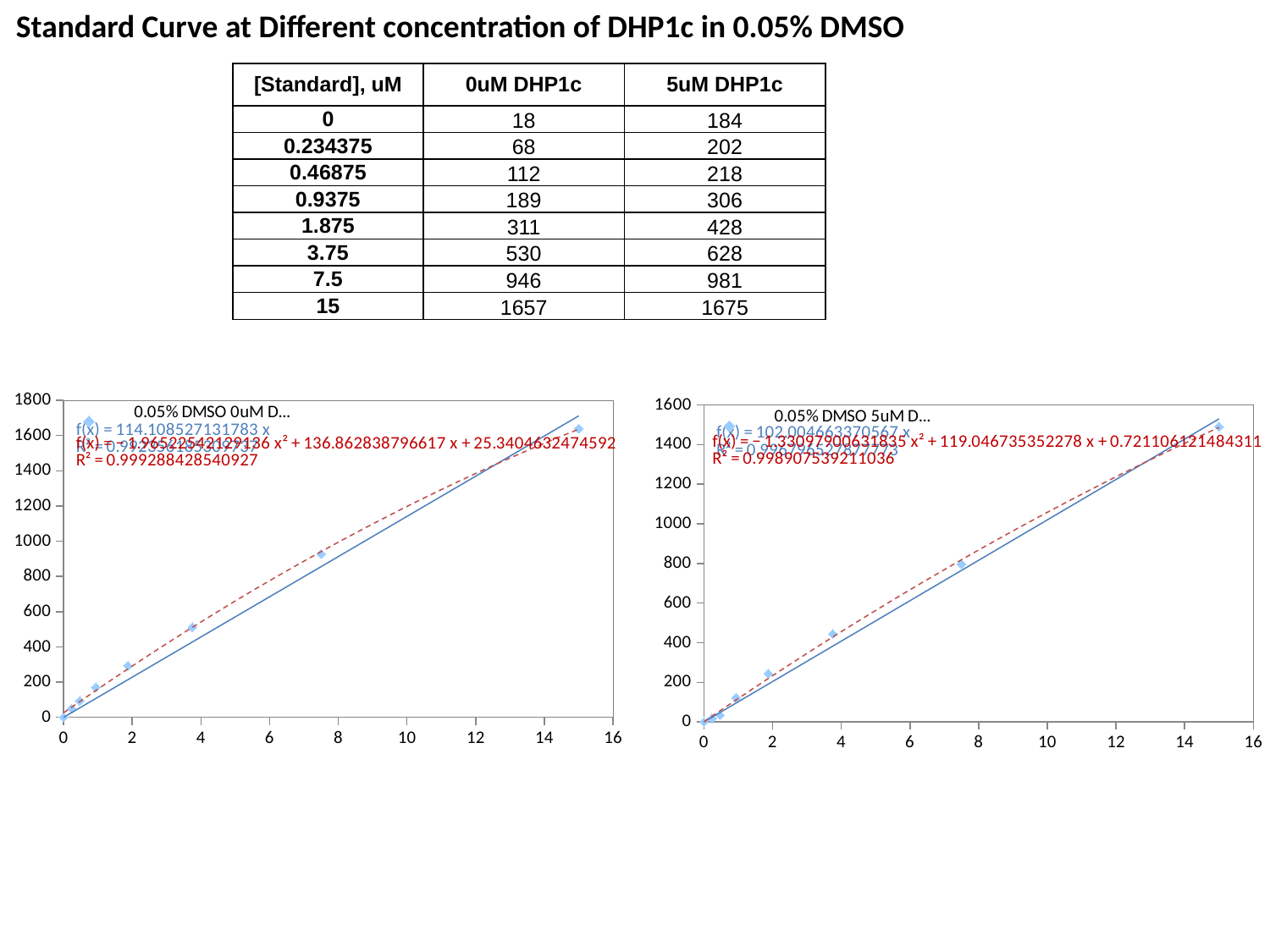
On the left chart (0.05% DMSO 0uM), is the value at x = 3.75 greater or less than 400? greater On the right chart (0.05% DMSO 5uM), at which x value is the plotted point highest? 15 How many data points are plotted on the right chart (0.05% DMSO 5uM)? 8 On the right chart (0.05% DMSO 5uM), is the value at x = 7.5 greater or less than 1000? less What kind of chart is the left chart (0.05% DMSO 0uM)? scatter chart On the right chart (0.05% DMSO 5uM), is the value at x = 15 greater or less than 1600? less What is the linear trendline equation shown in blue on the right chart (0.05% DMSO 5uM)? f(x) = 102.004663370567 x What is the R² value shown in red on the left chart (0.05% DMSO 0uM)? R² = 0.999288428540927 On the left chart (0.05% DMSO 0uM), do the plotted values rise or fall as x increases? rise